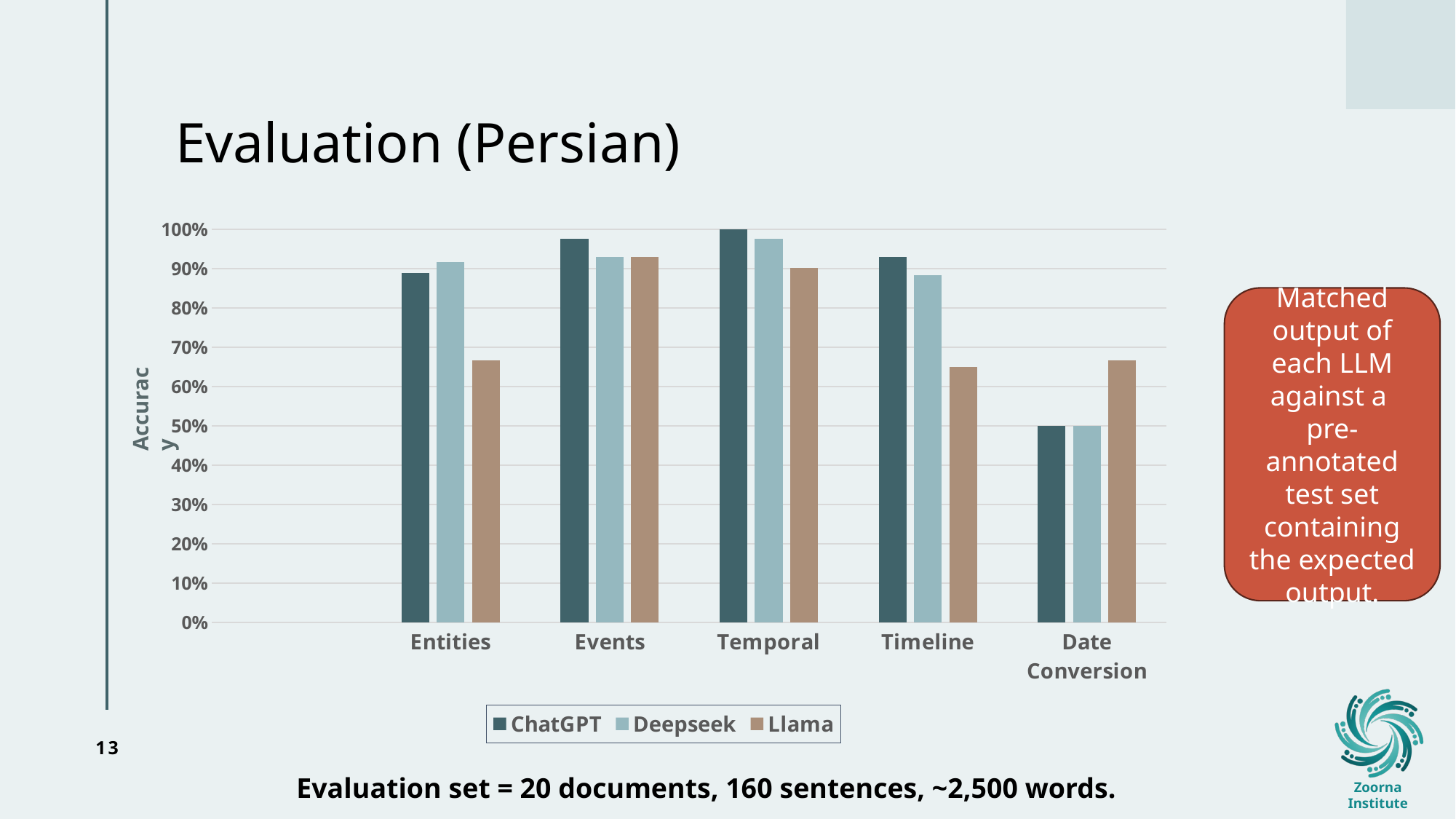
What is the label on the y axis of the chart? Accuracy Is the accuracy of Llama for Entities greater or less than 60%? greater For Date Conversion, which has the higher accuracy, ChatGPT or Llama? Llama How many series does the chart legend list? 3 What is the accuracy of ChatGPT for Date Conversion? 50% For Timeline, which has the higher accuracy, Deepseek or Llama? Deepseek In which category does ChatGPT reach its highest accuracy? Temporal How many categories are shown on the x axis of the chart? 5 Is the accuracy of Deepseek for Timeline greater or less than 80%? greater In which category does Deepseek have its lowest accuracy? Date Conversion What is the accuracy of ChatGPT for Temporal? 100% What kind of chart is shown on the slide? bar chart